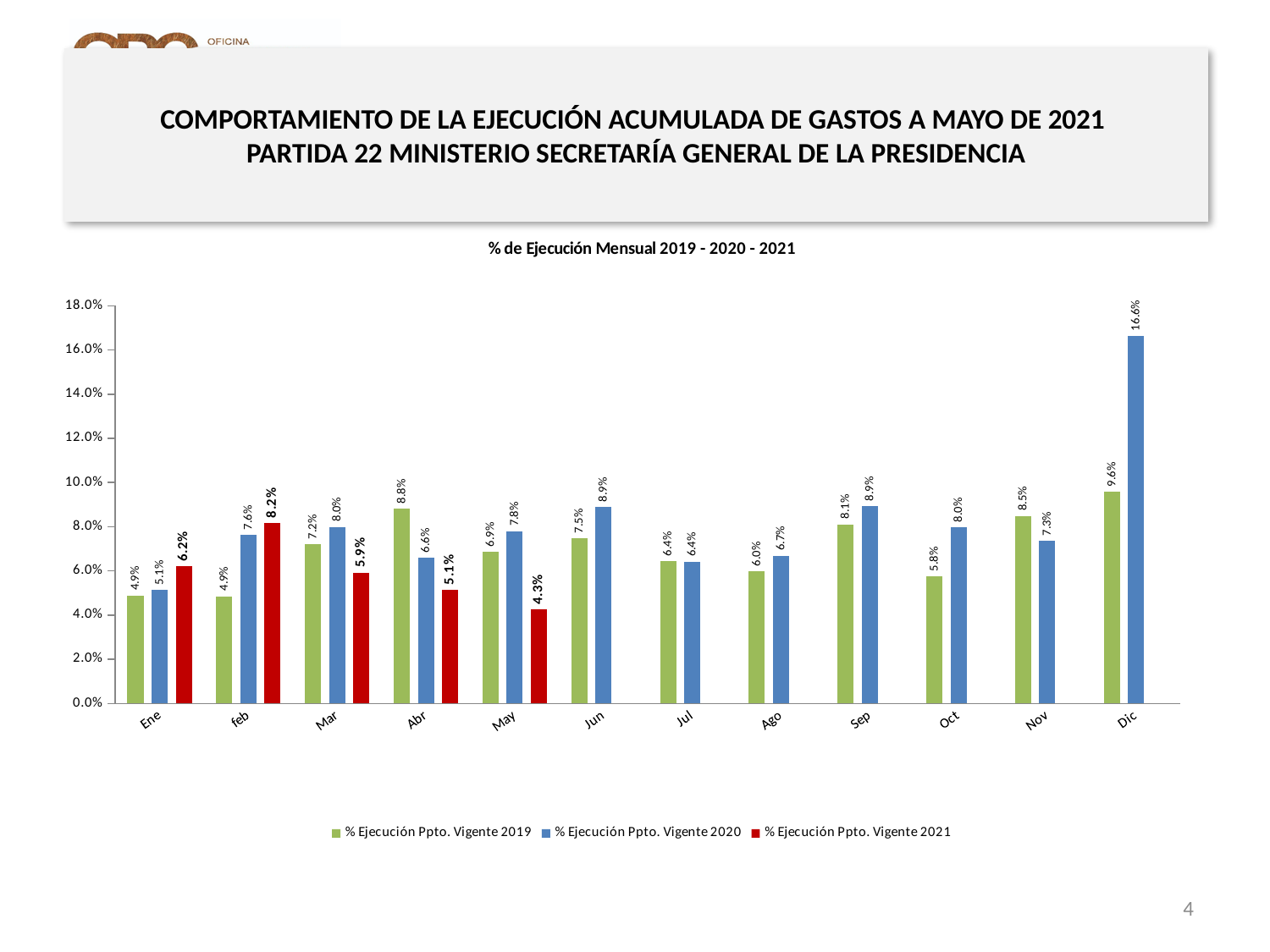
What is the value for % Ejecución Ppto. Vigente 2019 in Abr? 8.8% What is the value for % Ejecución Ppto. Vigente 2020 in Dic? 16.6% How many series does the legend list? 3 In which month is the % Ejecución Ppto. Vigente 2021 series highest? feb Which is larger in Mar: the 2020 value or the 2021 value? 2020 value (8.0%) Is the value for % Ejecución Ppto. Vigente 2020 in Dic greater or less than 14.0%? greater What kind of chart is shown? Bar chart What is the difference between the 2020 and 2019 values in Dic? 7.0% What is the value for % Ejecución Ppto. Vigente 2021 in Ene? 6.2% In which month is the % Ejecución Ppto. Vigente 2021 series lowest? May What colour represents % Ejecución Ppto. Vigente 2021? Red How many months are shown on the x axis? 12